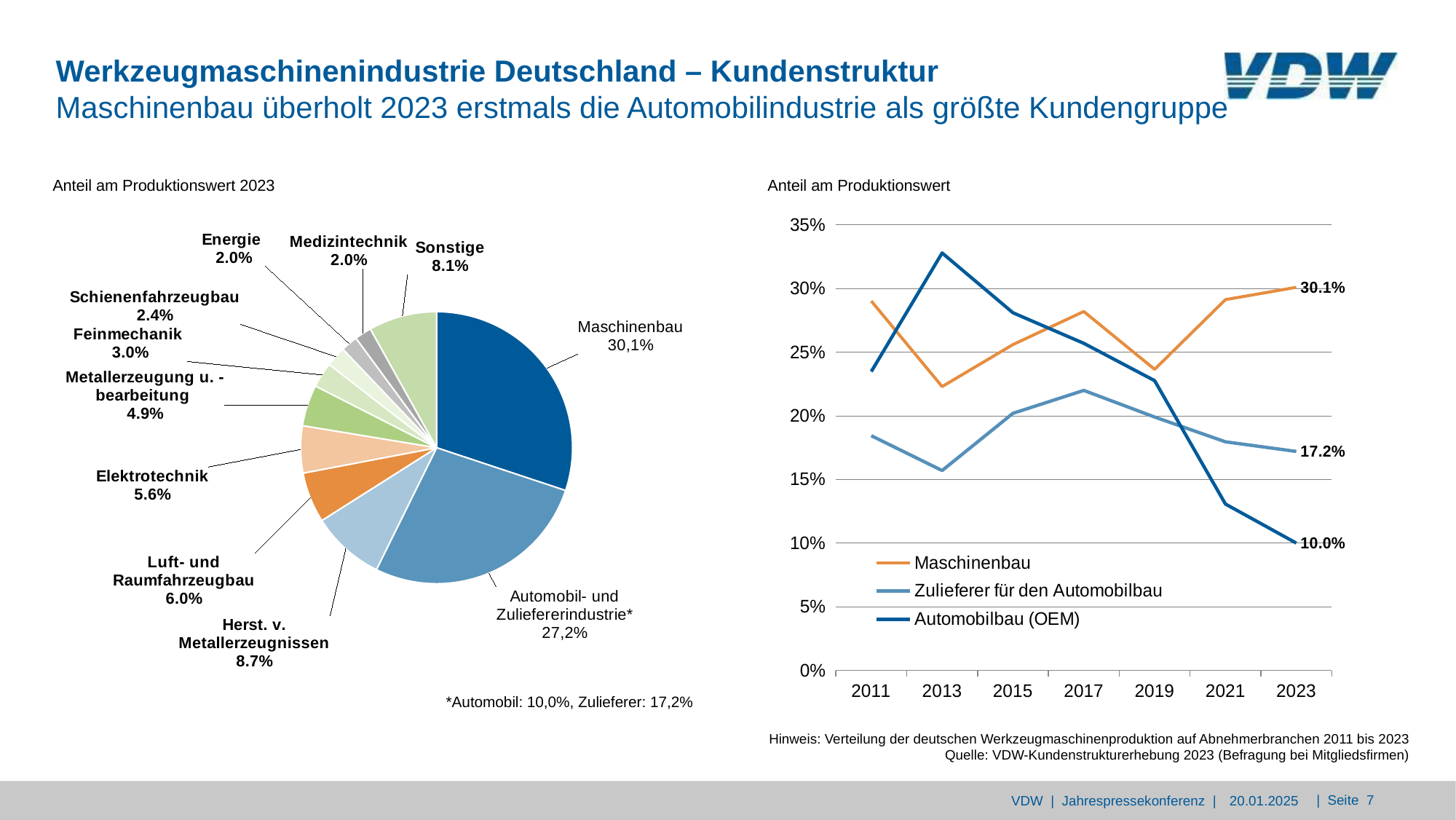
In the line chart 'Anteil am Produktionswert', does the Automobilbau (OEM) line rise or fall from 2013 to 2023? fall In the line chart 'Anteil am Produktionswert', what is the value for Zulieferer für den Automobilbau in 2023? 17.2% In the line chart 'Anteil am Produktionswert', is the value for Automobilbau (OEM) in 2013 greater or less than 30%? greater What type of chart is the right chart titled 'Anteil am Produktionswert'? line chart In the line chart 'Anteil am Produktionswert', how many series does the legend list? 3 In the pie chart 'Anteil am Produktionswert 2023', what share does Elektrotechnik have? 5.6% In the line chart 'Anteil am Produktionswert', what is the value for Automobilbau (OEM) in 2023? 10.0% What type of chart is the left chart titled 'Anteil am Produktionswert 2023'? pie chart In the pie chart 'Anteil am Produktionswert 2023', how many slices are shown? 11 In the pie chart 'Anteil am Produktionswert 2023', what share does Maschinenbau have? 30,1% In the pie chart 'Anteil am Produktionswert 2023', which category has the largest share? Maschinenbau In the pie chart 'Anteil am Produktionswert 2023', which is larger: Luft- und Raumfahrzeugbau or Herst. v. Metallerzeugnissen? Herst. v. Metallerzeugnissen